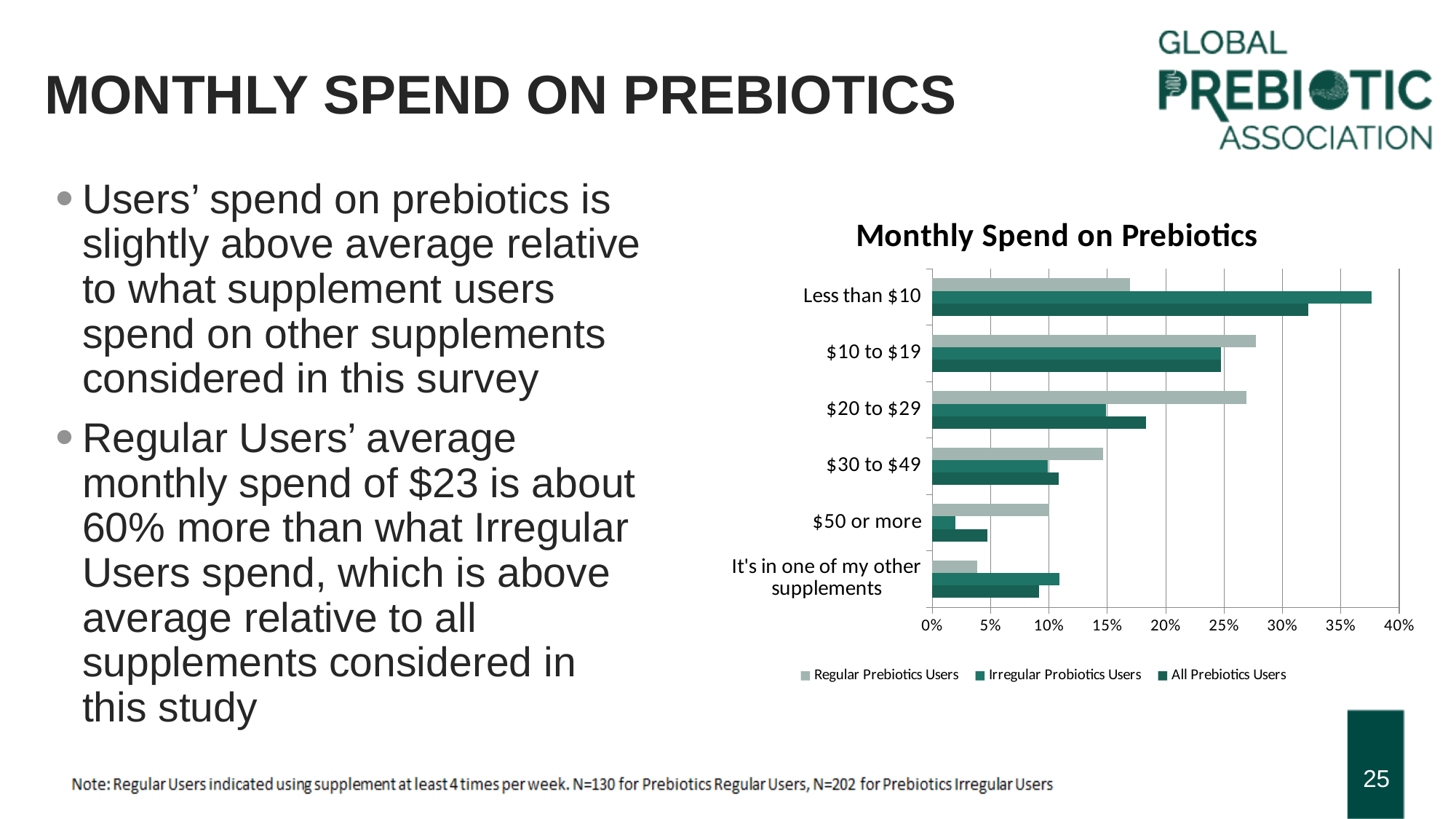
How many spend categories are shown on the chart? 6 In the '$20 to $29' category, which is larger: Regular Prebiotics Users or Irregular Probiotics Users? Regular Prebiotics Users How many series does the chart's legend list? 3 For Irregular Probiotics Users, which category has the lowest value? $50 or more Is the value for Irregular Probiotics Users in the 'Less than $10' category greater or less than 35%? greater For Regular Prebiotics Users, which category has the lowest value? It's in one of my other supplements What kind of chart is shown on the slide? Bar chart Is the value for All Prebiotics Users in the 'Less than $10' category greater or less than 30%? greater For Irregular Probiotics Users, which spend category has the highest value? Less than $10 In the 'Less than $10' category, which is larger: Regular Prebiotics Users or Irregular Probiotics Users? Irregular Probiotics Users What is the title of the chart? Monthly Spend on Prebiotics Is the value for Regular Prebiotics Users in the '$50 or more' category greater or less than 15%? less